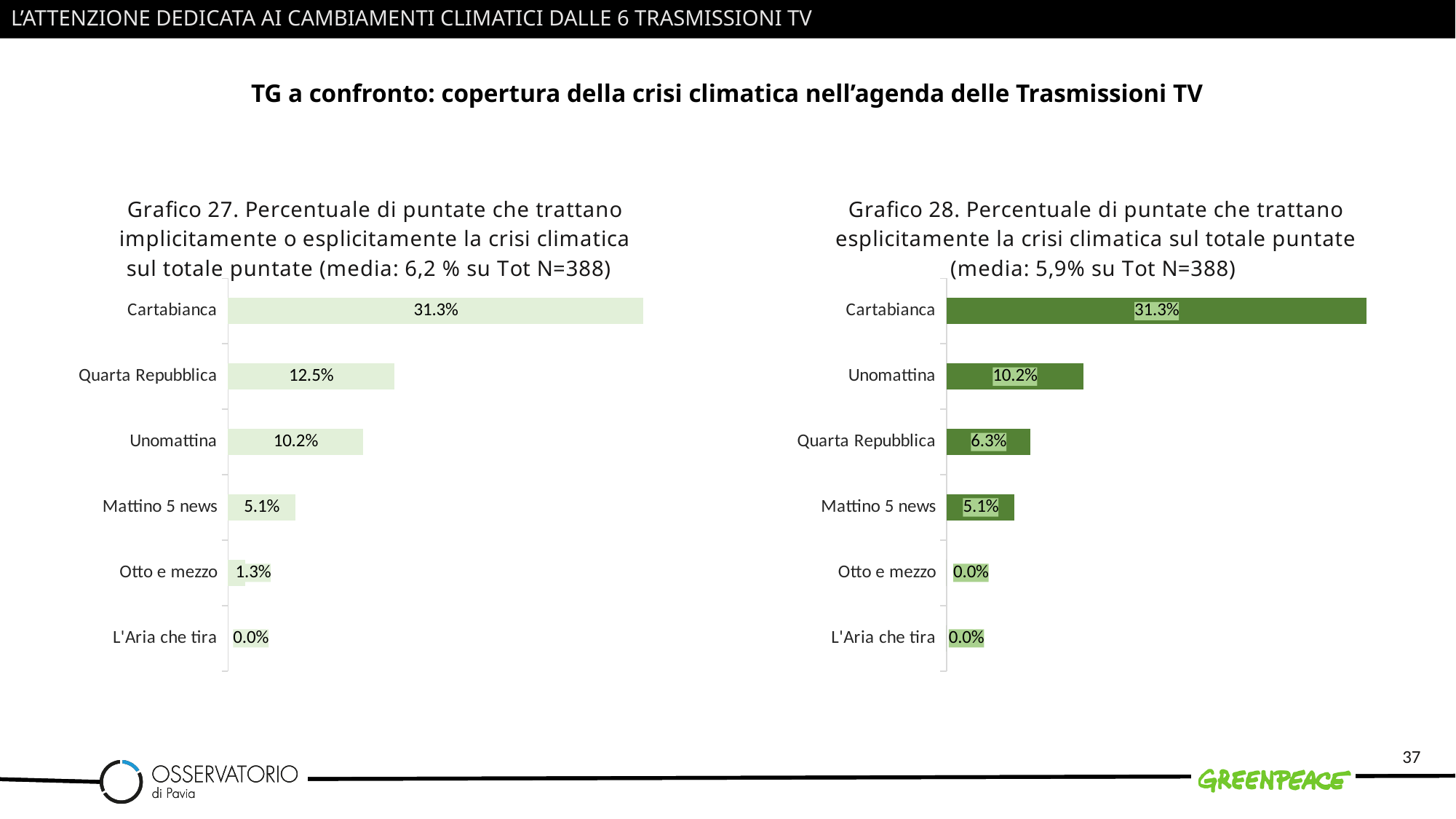
In Grafico 27 (left chart), which is larger: Unomattina or Mattino 5 news? Unomattina In Grafico 27 (left chart), which programme has the lowest value? L'Aria che tira In Grafico 28 (right chart), what is the value for Quarta Repubblica? 6.3% What kind of chart is Grafico 27 (left chart)? Bar chart What is the average (media) stated in the title of Grafico 28 (right chart)? 5,9% In Grafico 27 (left chart), what is the difference between Cartabianca and Quarta Repubblica? 18.8% In Grafico 27 (left chart), what is the value for Quarta Repubblica? 12.5% In Grafico 27 (left chart), what is the value for Otto e mezzo? 1.3% How many programmes are shown in Grafico 28 (right chart)? 6 In Grafico 28 (right chart), which programme has the highest value? Cartabianca In Grafico 28 (right chart), what is the difference between Unomattina and Mattino 5 news? 5.1% In Grafico 28 (right chart), what is the value for Otto e mezzo? 0.0%